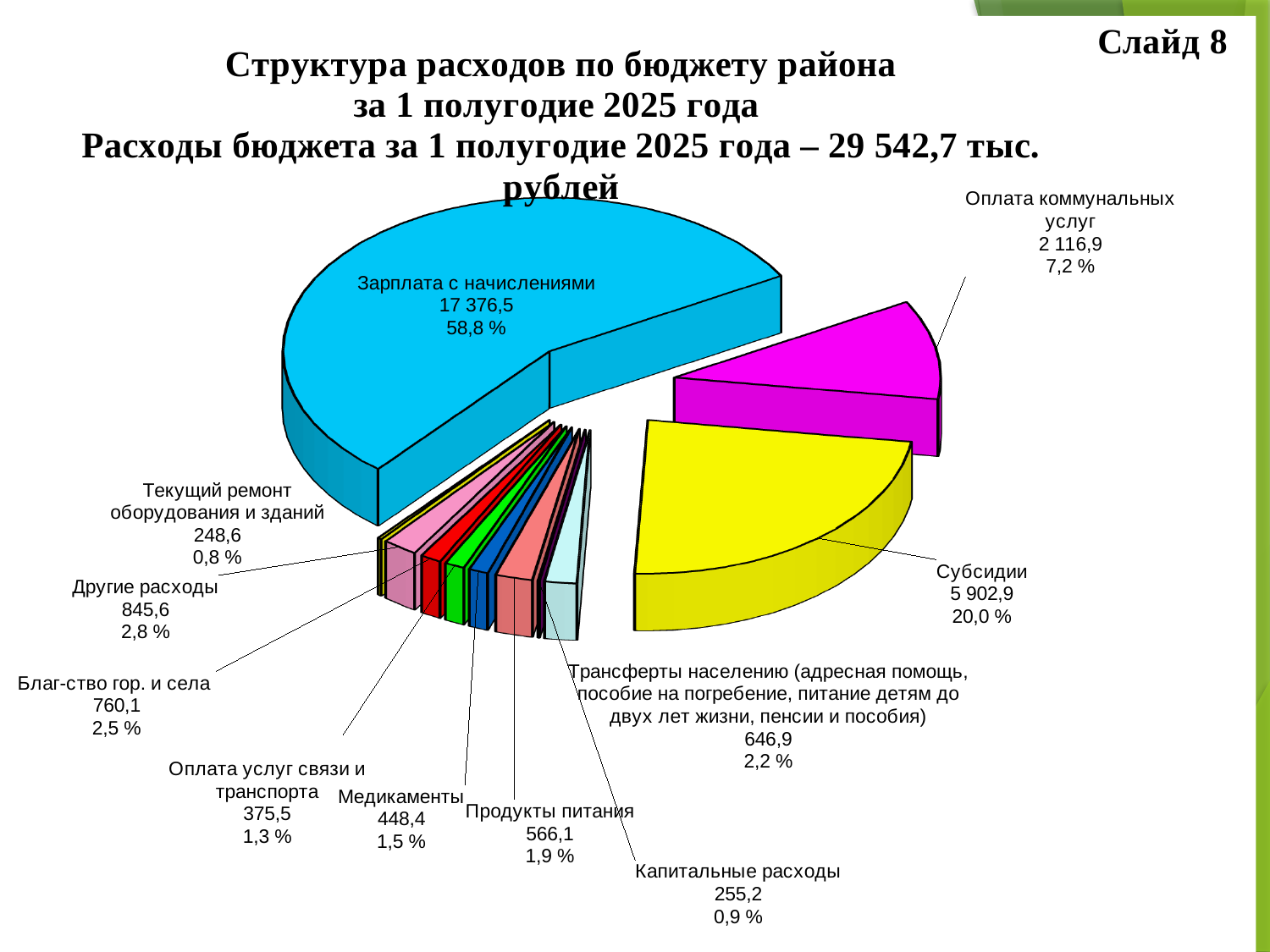
What total budget expenditure for the first half of 2025 is stated in the chart title? 29 542,7 тыс. рублей What share of the pie does Субсидии represent? 20,0 % Which category has the largest slice of the pie? Зарплата с начислениями Which is larger: Продукты питания or Медикаменты? Продукты питания How many categories are shown in the pie chart? 11 What share of the pie does Капитальные расходы represent? 0,9 % What is the difference between the values for Субсидии and Оплата коммунальных услуг? 3 786,0 What is the value for Зарплата с начислениями? 17 376,5 What type of chart is shown on the slide? pie chart Which category has the smallest slice of the pie? Текущий ремонт оборудования и зданий What is the value for Другие расходы? 845,6 What is the value for Оплата коммунальных услуг? 2 116,9